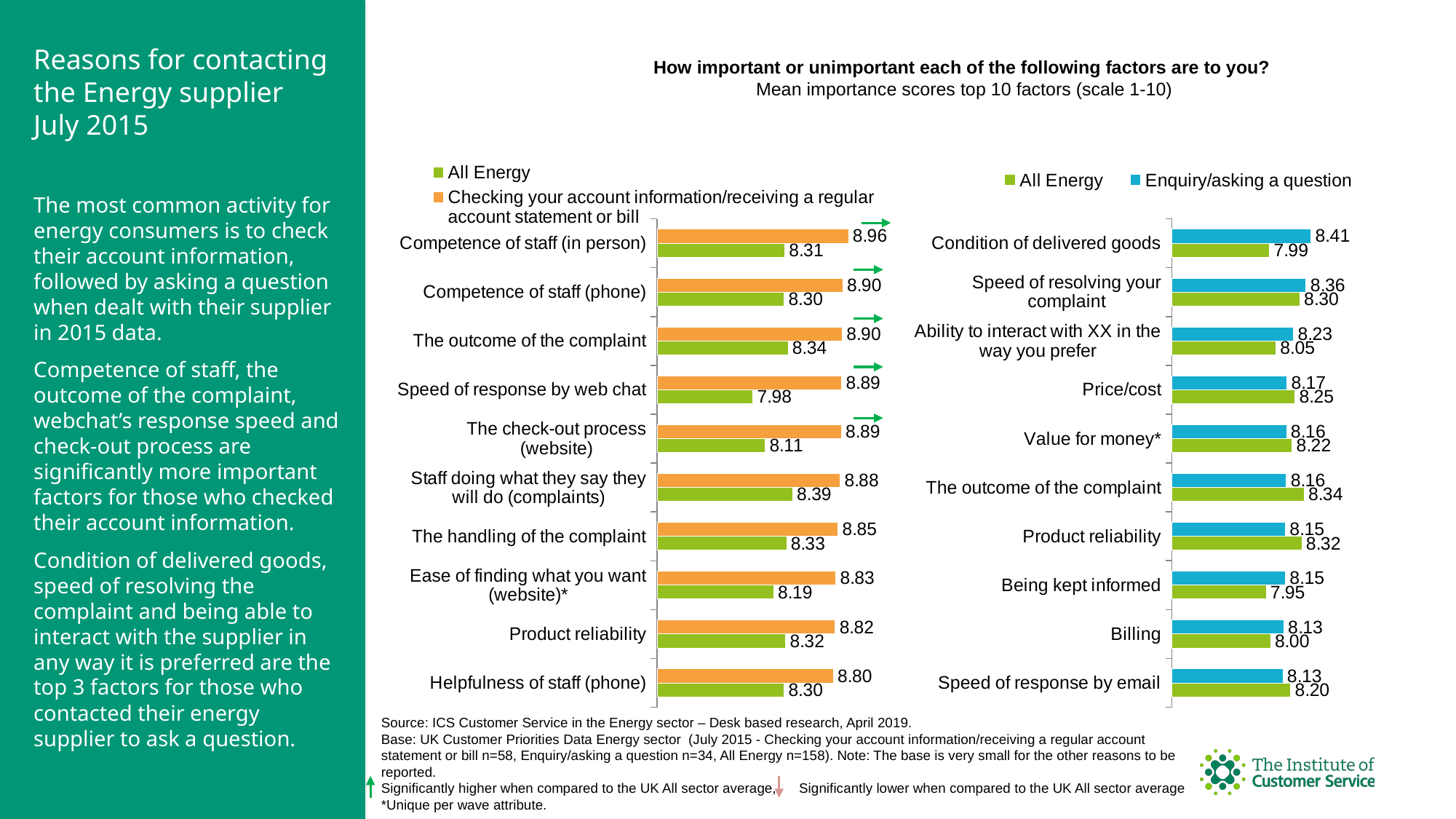
In the left chart, which category has the lowest All Energy value? Speed of response by web chat In the right chart, what is the difference between the Enquiry/asking a question value and the All Energy value for Being kept informed? 0.20 In the right chart, what colour are the bars for the Enquiry/asking a question series? Blue In the left chart, what is the difference between the Checking your account information value and the All Energy value for Speed of response by web chat? 0.91 In the right chart, which category has the highest Enquiry/asking a question value? Condition of delivered goods In the right chart, what is the All Energy value for Condition of delivered goods? 7.99 In the right chart, which is larger for Price/cost: the Enquiry/asking a question value or the All Energy value? All Energy How many series does the legend of the right chart list? 2 In the left chart, what is the All Energy value for Staff doing what they say they will do (complaints)? 8.39 In the left chart, what is the value for Competence of staff (in person) for the Checking your account information/receiving a regular account statement or bill series? 8.96 What type of chart is the left chart? Bar chart How many categories are shown in the left chart? 10